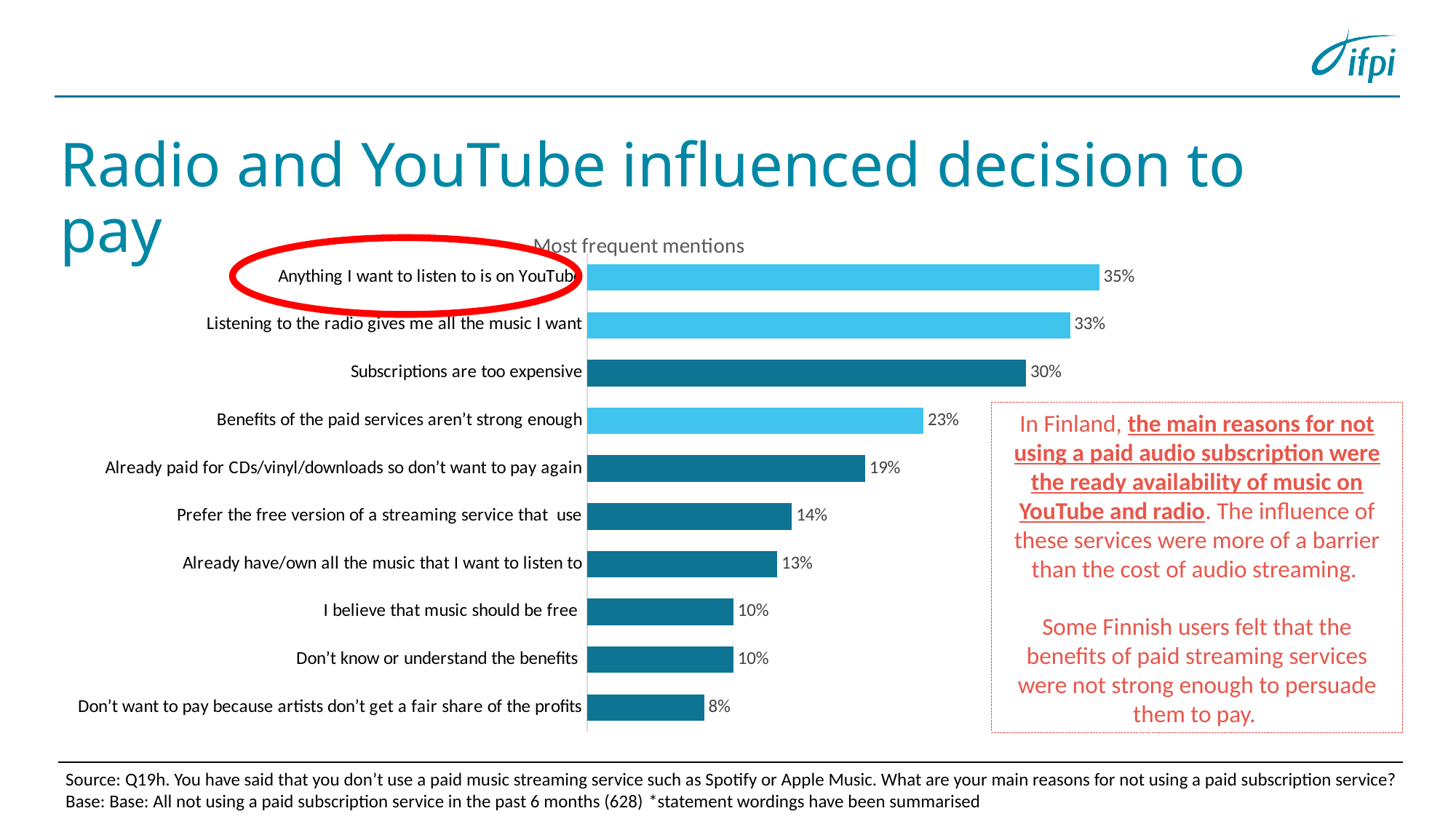
Which reason has the highest percentage of mentions? Anything I want to listen to is on YouTube How many reasons (categories) are shown in the chart? 10 What is the value for "Subscriptions are too expensive"? 30% Which category is circled in red on the chart? Anything I want to listen to is on YouTube What type of chart is shown on the slide? Bar chart What is the title shown above the chart? Most frequent mentions Which reason has the lowest percentage of mentions? Don't want to pay because artists don't get a fair share of the profits What is the difference between the highest and lowest values in the chart? 27% Which is larger: "Benefits of the paid services aren't strong enough" or "Prefer the free version of a streaming service that use"? Benefits of the paid services aren't strong enough What is the difference between "Listening to the radio gives me all the music I want" and "Subscriptions are too expensive"? 3% What percentage of respondents said "Anything I want to listen to is on YouTube"? 35% What percentage is shown for "Already paid for CDs/vinyl/downloads so don't want to pay again"? 19%